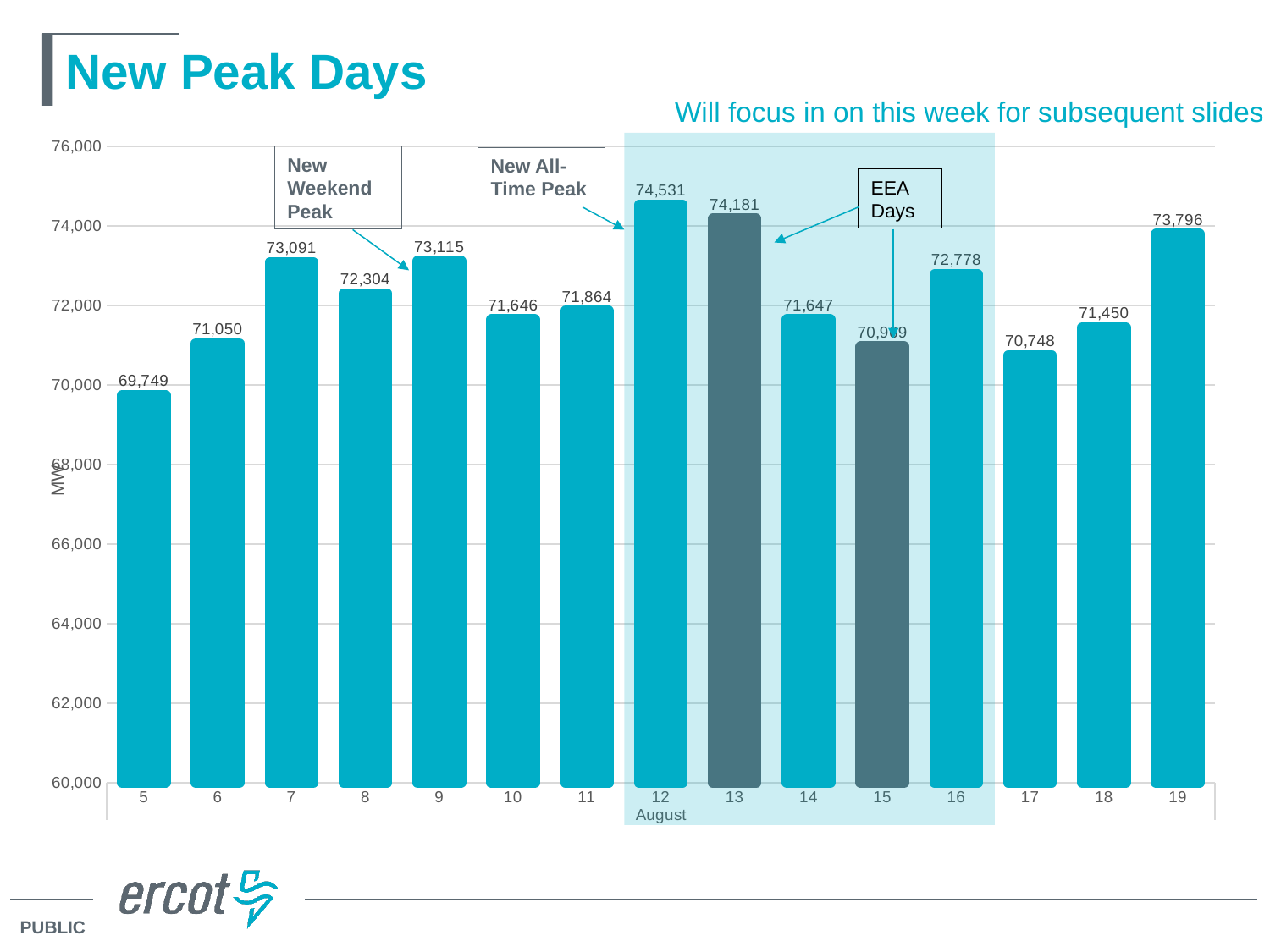
Which day has the highest value on the New Peak Days chart? 12 How many days are plotted on the New Peak Days chart? 15 Which day has the lowest value on the New Peak Days chart? 5 Which has a larger value, August 19 or August 16? August 19 Which day is labelled as the New All-Time Peak on the chart? August 12 Do the values rise or fall from August 5 to August 7? rise What is the difference between the values for August 12 and August 13? 350 What is the value for August 19 on the New Peak Days chart? 73,796 What is the value for August 5 on the New Peak Days chart? 69,749 What kind of chart is shown on the slide? bar chart What is the value for August 12 on the New Peak Days chart? 74,531 Is the value for August 17 greater or less than 72,000? less